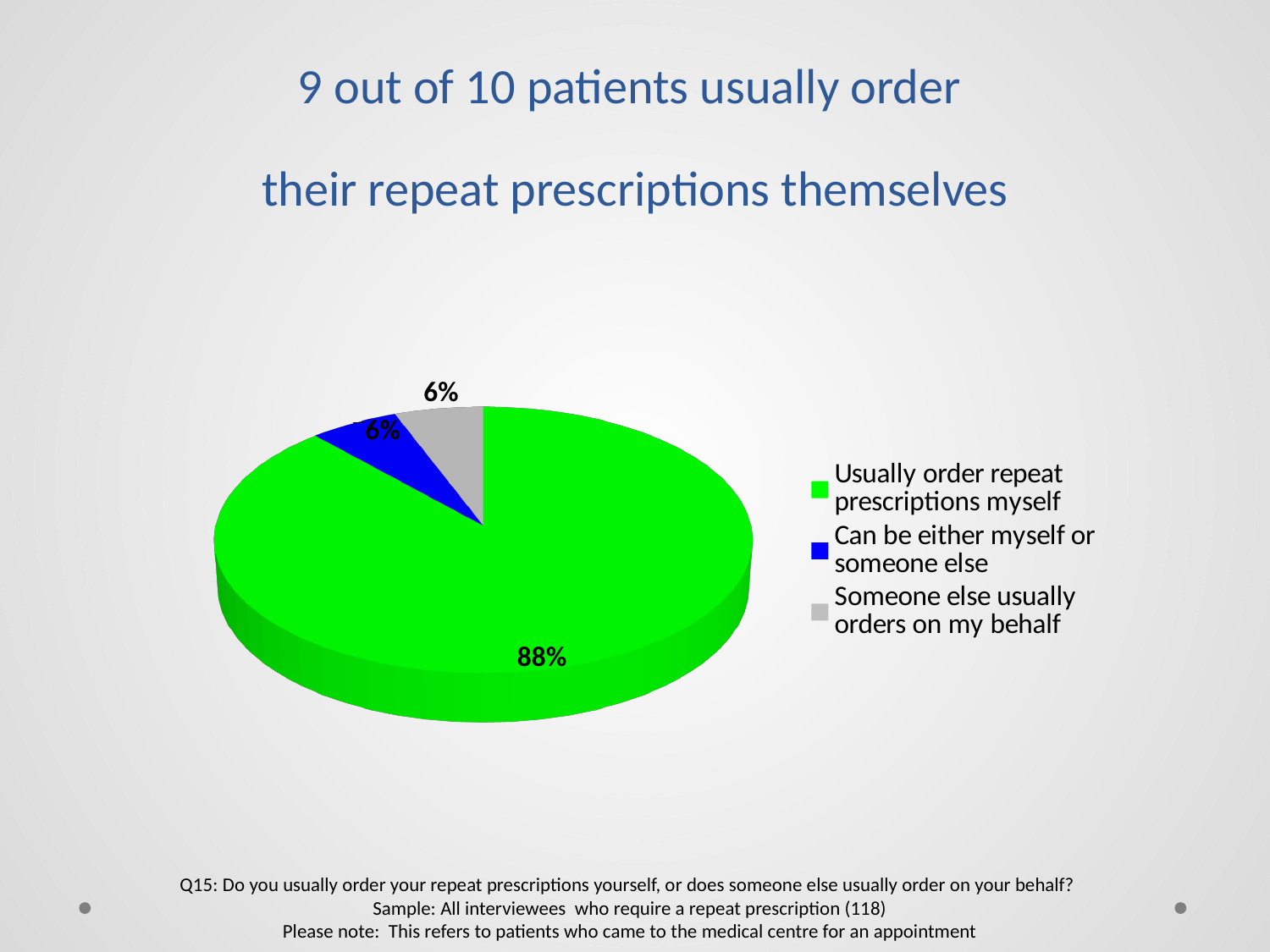
Which is larger: the share for 'Usually order repeat prescriptions myself' or the share for 'Can be either myself or someone else'? Usually order repeat prescriptions myself What colour is the slice for 'Can be either myself or someone else'? blue Is the share for 'Usually order repeat prescriptions myself' greater or less than 50%? greater What percentage of patients say someone else usually orders on their behalf? 6% What percentage of patients say it can be either themselves or someone else who orders? 6% What percentage of patients usually order repeat prescriptions themselves? 88% How many slices does the pie chart have? 3 Which category has the largest share of the pie? Usually order repeat prescriptions myself What kind of chart is shown on the slide? pie chart What colour is the slice for 'Someone else usually orders on my behalf'? grey How many entries does the legend list? 3 What is the difference in percentage points between 'Usually order repeat prescriptions myself' and 'Someone else usually orders on my behalf'? 82